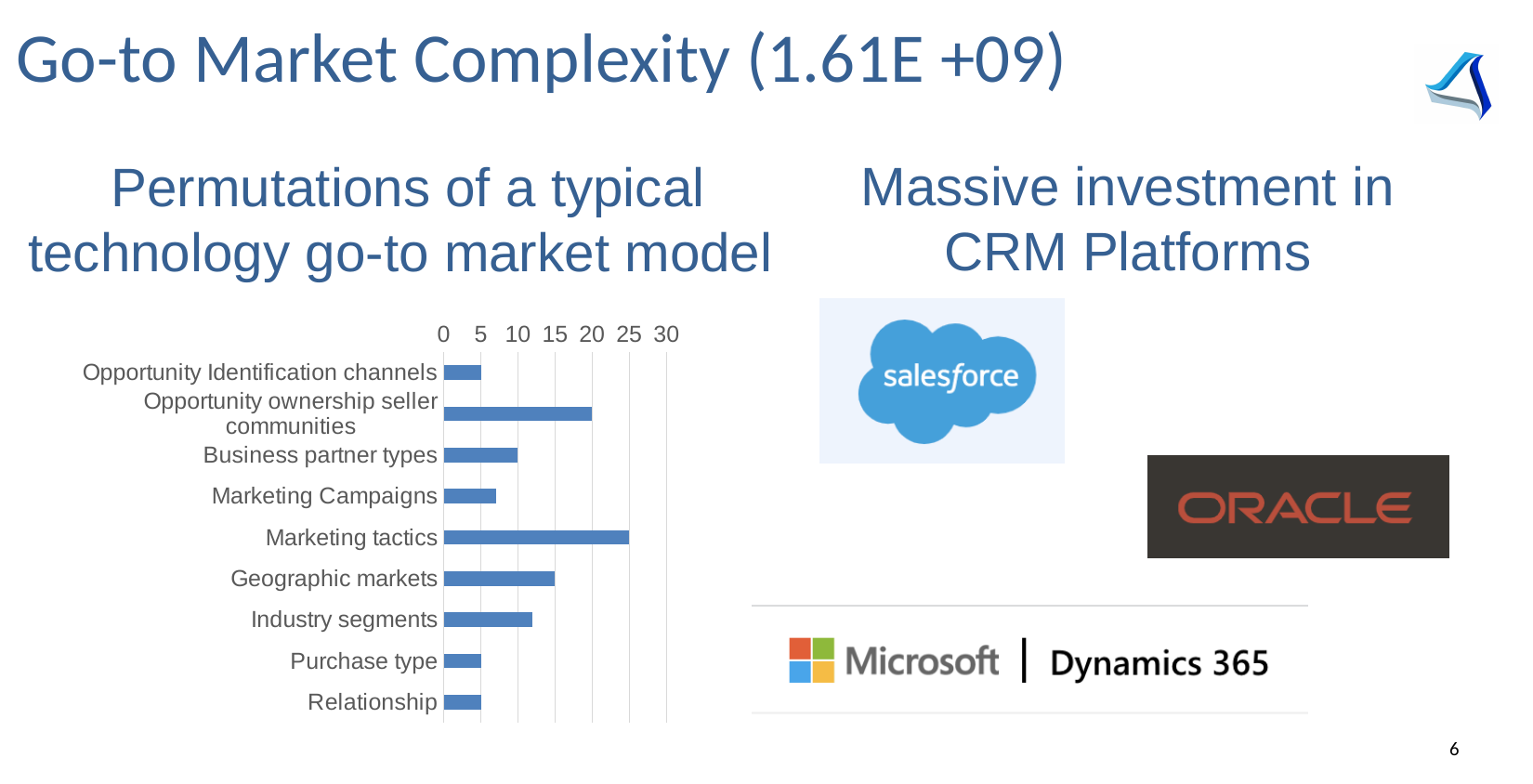
What is the value for Opportunity ownership seller communities? 20 What is the difference between the values for Marketing tactics and Geographic markets? 10 What is the value for Geographic markets? 15 Which is larger, the value for Geographic markets or the value for Business partner types? Geographic markets What is the value for Marketing tactics? 25 What is the value for Business partner types? 10 What type of chart is shown on the slide? bar chart Which category has the highest value in the bar chart? Marketing tactics How many categories does the bar chart show? 9 What is the highest value shown on the chart's axis? 30 Is the value for Marketing Campaigns greater or less than 10? less Is the value for Industry segments greater or less than 10? greater